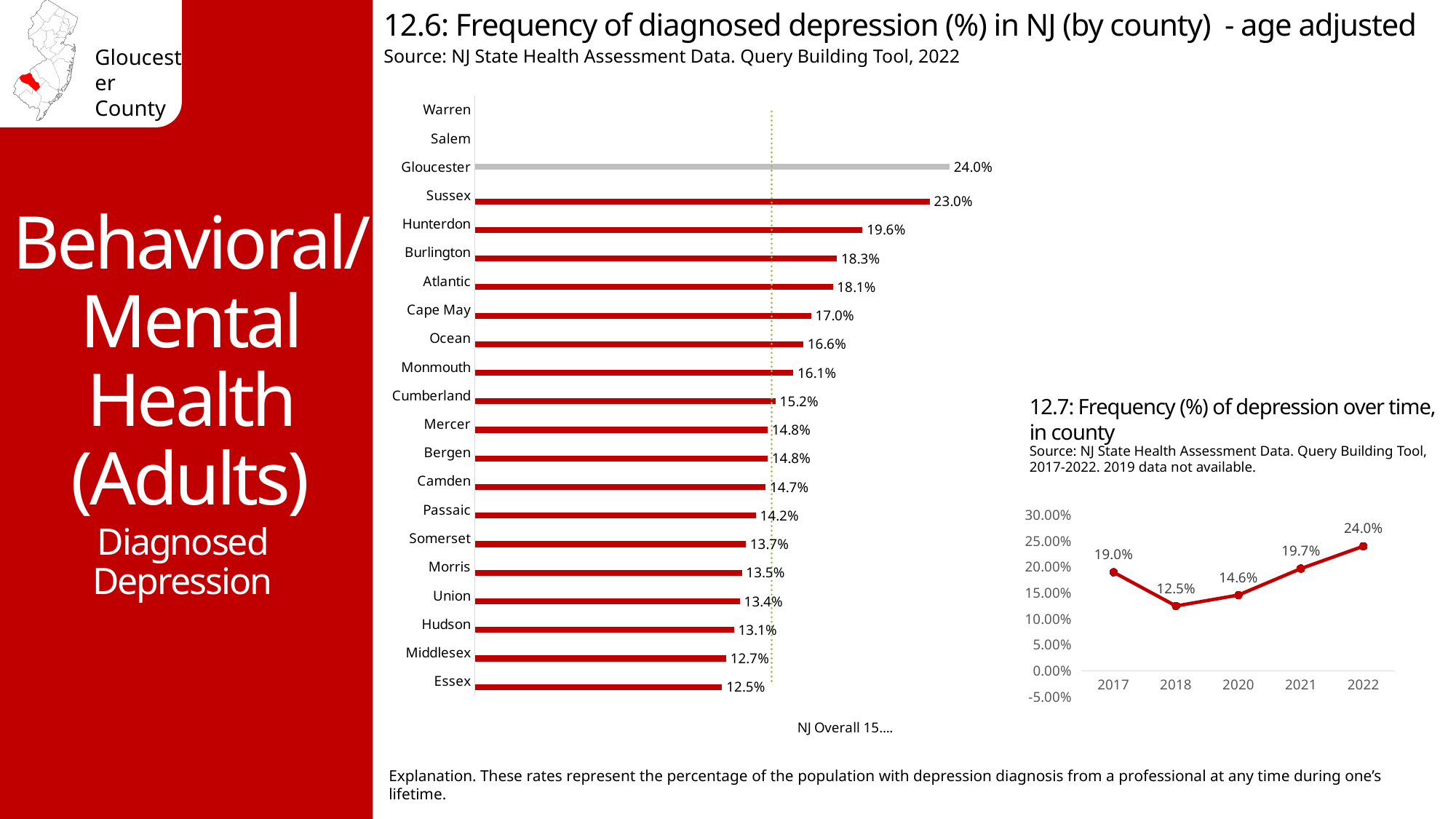
In chart 12.6, which county has the highest value? Gloucester In chart 12.7, what is the value for 2022? 24.0% In chart 12.7, what is the difference between the 2022 and 2017 values? 5.0% What kind of chart is chart 12.6? Bar chart In chart 12.7, what is the value for 2018? 12.5% In chart 12.7, how many data points are plotted? 5 In chart 12.6, which has a larger value, Burlington or Atlantic? Burlington In chart 12.7, do the values rise or fall from 2018 to 2022? Rise In chart 12.6, what is the difference between the values for Gloucester and Sussex? 1.0% In chart 12.6, which county with a plotted bar has the lowest value? Essex In chart 12.6, what is the value shown for Hunterdon? 19.6% In chart 12.6, what is the frequency of diagnosed depression for Gloucester County? 24.0%